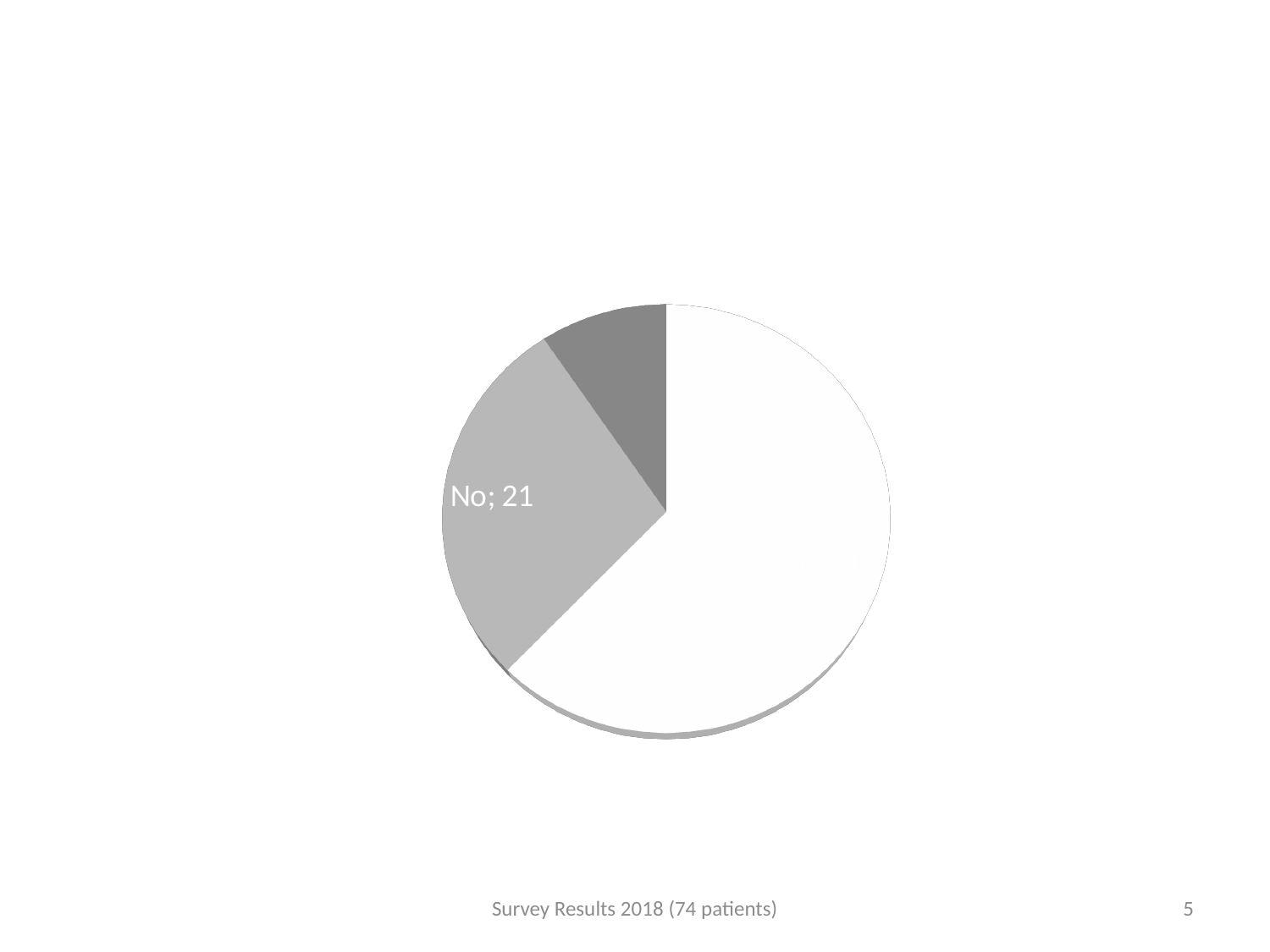
Does the slice labelled "No" take up more or less than half of the pie? less How many slices does the pie chart have? 3 Is the slice labelled "No" the largest slice of the pie? No Which slice of the pie carries a data label? No Is the slice labelled "No" larger or smaller than the dark grey slice? larger Is the slice labelled "No" larger or smaller than the white slice? smaller Which slice is the smallest: the white slice, the slice labelled "No", or the dark grey slice? the dark grey slice What value is shown for the slice labelled "No"? 21 What kind of chart is shown on the slide? pie chart